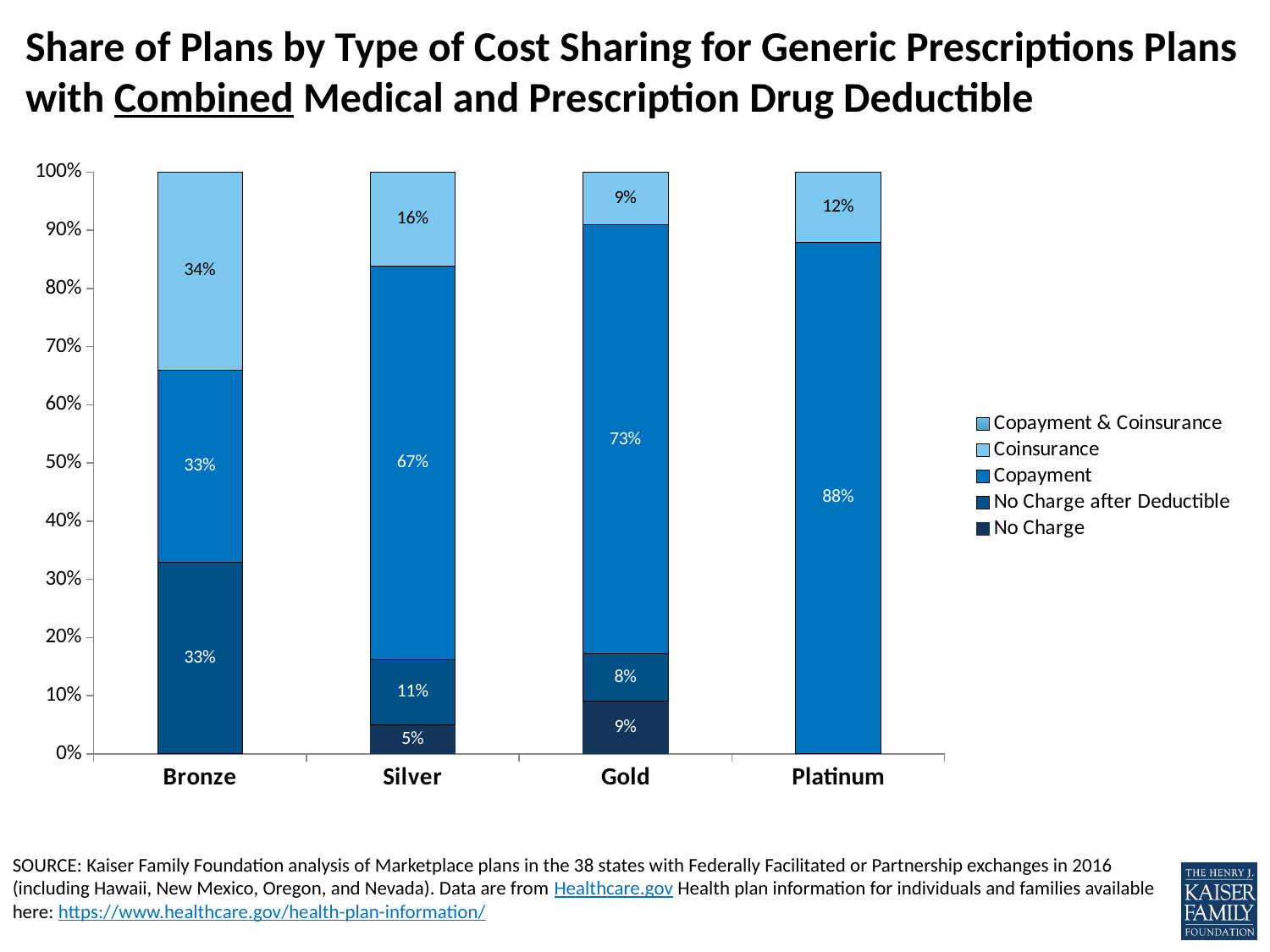
How many series does the legend list? 5 How many plan types are shown on the x axis? 4 Which plan type has the lowest Copayment share? Bronze Does the Copayment share rise or fall moving from Bronze to Platinum? Rises What is the Copayment share for Silver plans? 67% What is the difference between the Copayment share for Platinum and for Gold? 15 percentage points Which plan type has the highest Copayment share? Platinum What kind of chart is shown on the slide? Stacked bar chart What is the Copayment share for Gold plans? 73% What is the Copayment share for Bronze plans? 33% What is the Copayment share for Platinum plans? 88% Which has a larger Copayment share, Silver or Gold? Gold